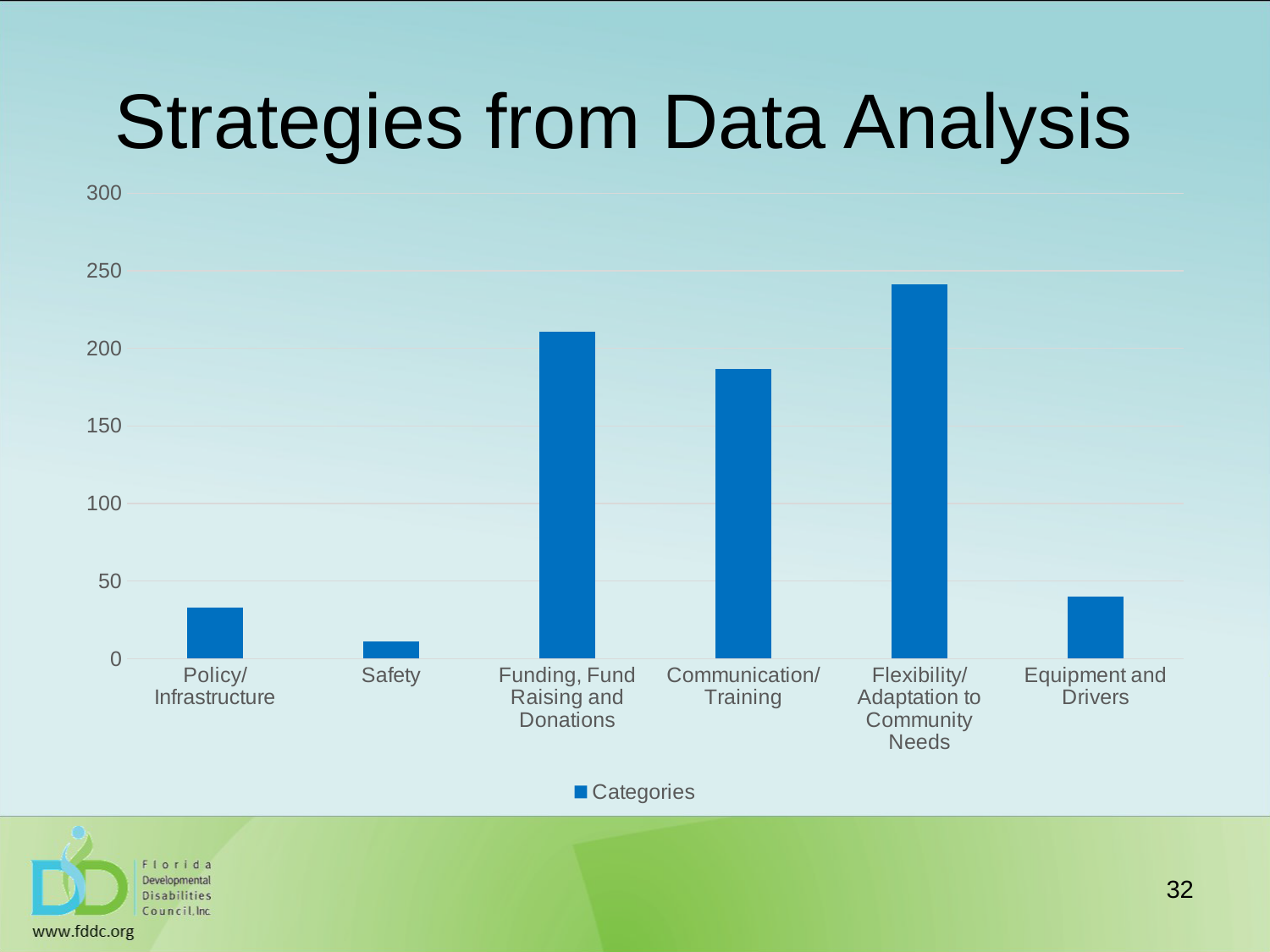
Which category has the lowest bar? Safety Which is larger, the value for Funding, Fund Raising and Donations or the value for Communication/Training? Funding, Fund Raising and Donations Is the value for Communication/Training greater or less than 150? greater Is the value for Flexibility/Adaptation to Community Needs greater or less than 200? greater How many series does the legend list? 1 Is the value for Safety greater or less than 50? less What kind of chart is shown on the slide? bar chart How many categories are shown on the x axis of the chart? 6 Which is larger, the value for Equipment and Drivers or the value for Safety? Equipment and Drivers What is the title of the chart on the slide? Strategies from Data Analysis Which category has the highest bar? Flexibility/Adaptation to Community Needs